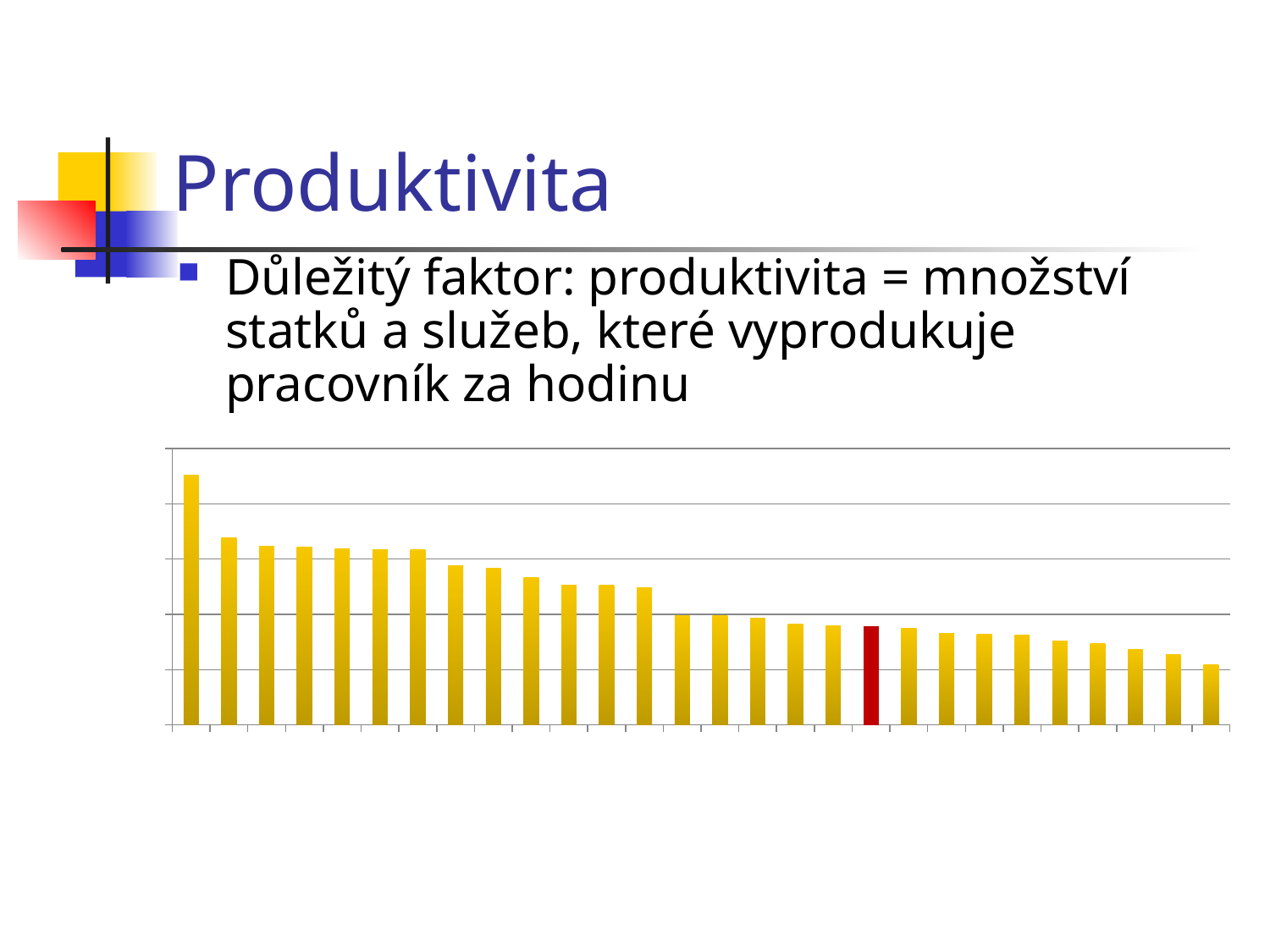
What colour is the single highlighted bar that differs from the others? red How many bars are plotted in the chart? 28 Which bar in the chart is the shortest? the rightmost (last) bar Is the leftmost bar taller or shorter than the second bar from the left? taller Which bar in the chart is the tallest? the leftmost (first) bar Do the bar values rise or fall from left to right across the chart? fall What kind of chart is shown on the slide? bar chart What colour are most of the bars in the chart? yellow